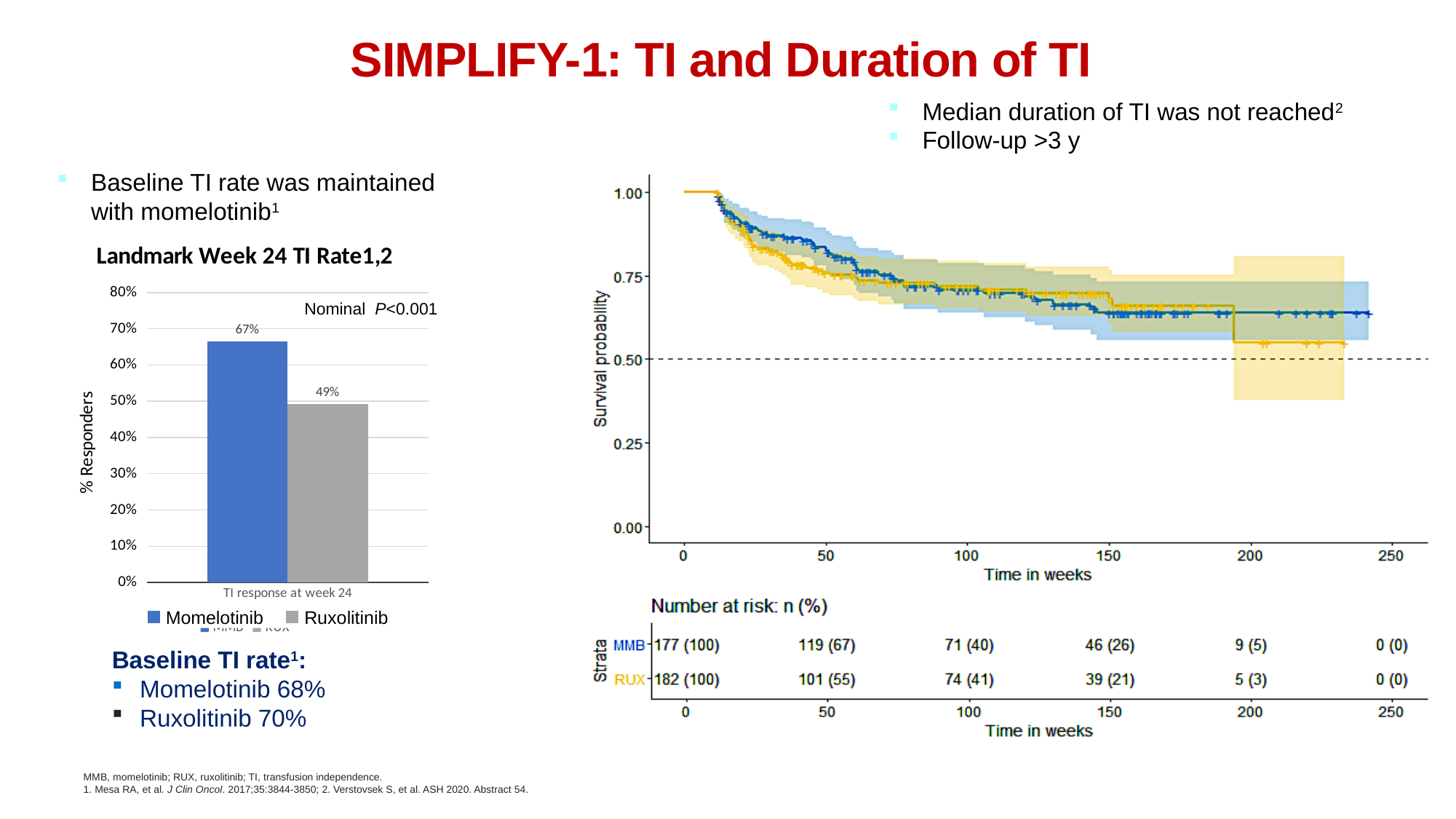
In the Landmark Week 24 TI Rate bar chart, what is the difference in percentage points between the Momelotinib and Ruxolitinib TI response rates? 18% In the Landmark Week 24 TI Rate bar chart, what is the nominal P value shown? P<0.001 In the Landmark Week 24 TI Rate bar chart, what is the TI response rate for Ruxolitinib? 49% In the survival probability chart on the right, what is the number at risk for RUX at 50 weeks? 101 (55) In the survival probability chart on the right, what is the number at risk for MMB at 0 weeks? 177 (100) What kind of chart is the Landmark Week 24 TI Rate chart? Bar chart In the Landmark Week 24 TI Rate bar chart, how many series does the legend list? 2 In the survival probability chart on the right, do the survival probability curves rise or fall as time in weeks increases? Fall In the Landmark Week 24 TI Rate bar chart, which treatment has the higher TI response rate? Momelotinib In the Landmark Week 24 TI Rate bar chart, what is the TI response rate for Momelotinib? 67% In the Landmark Week 24 TI Rate bar chart, what colour is the Ruxolitinib bar? Grey In the survival probability chart on the right, is the MMB survival probability at 100 weeks greater or less than 0.50? greater